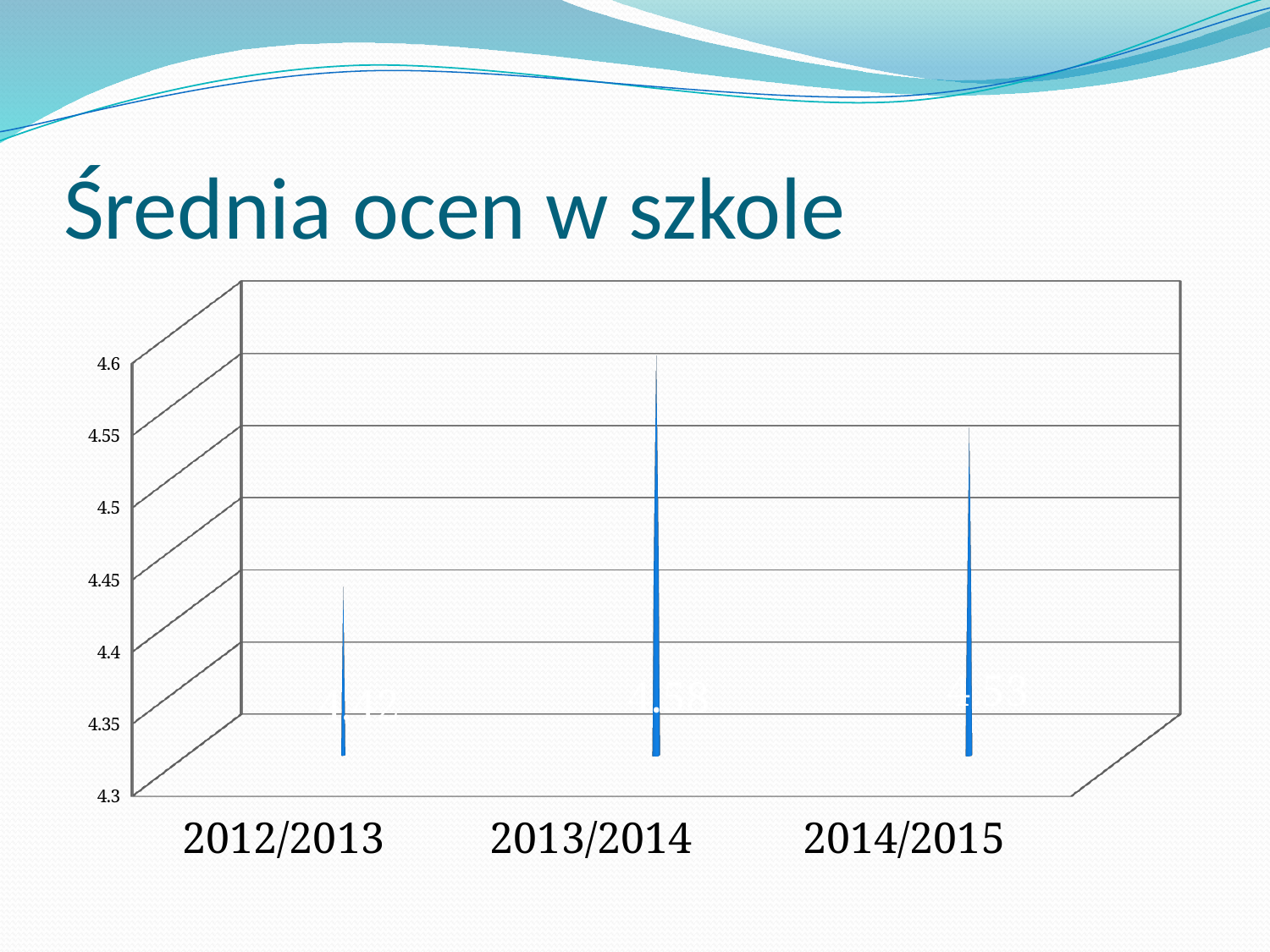
Which school year has the highest average grade? 2013/2014 Is the value for 2012/2013 greater or less than 4.5? less How many school years (categories) are shown on the x axis? 3 Which is higher, the value for 2012/2013 or the value for 2014/2015? 2014/2015 Is the value for 2012/2013 greater or less than 4.4? greater Does the average grade rise or fall from 2012/2013 to 2013/2014? rise What is the title of the chart? Średnia ocen w szkole What kind of chart is shown on the slide? bar chart Is the value for 2014/2015 greater or less than 4.6? less Which is higher, the value for 2013/2014 or the value for 2014/2015? 2013/2014 Which school year has the lowest average grade? 2012/2013